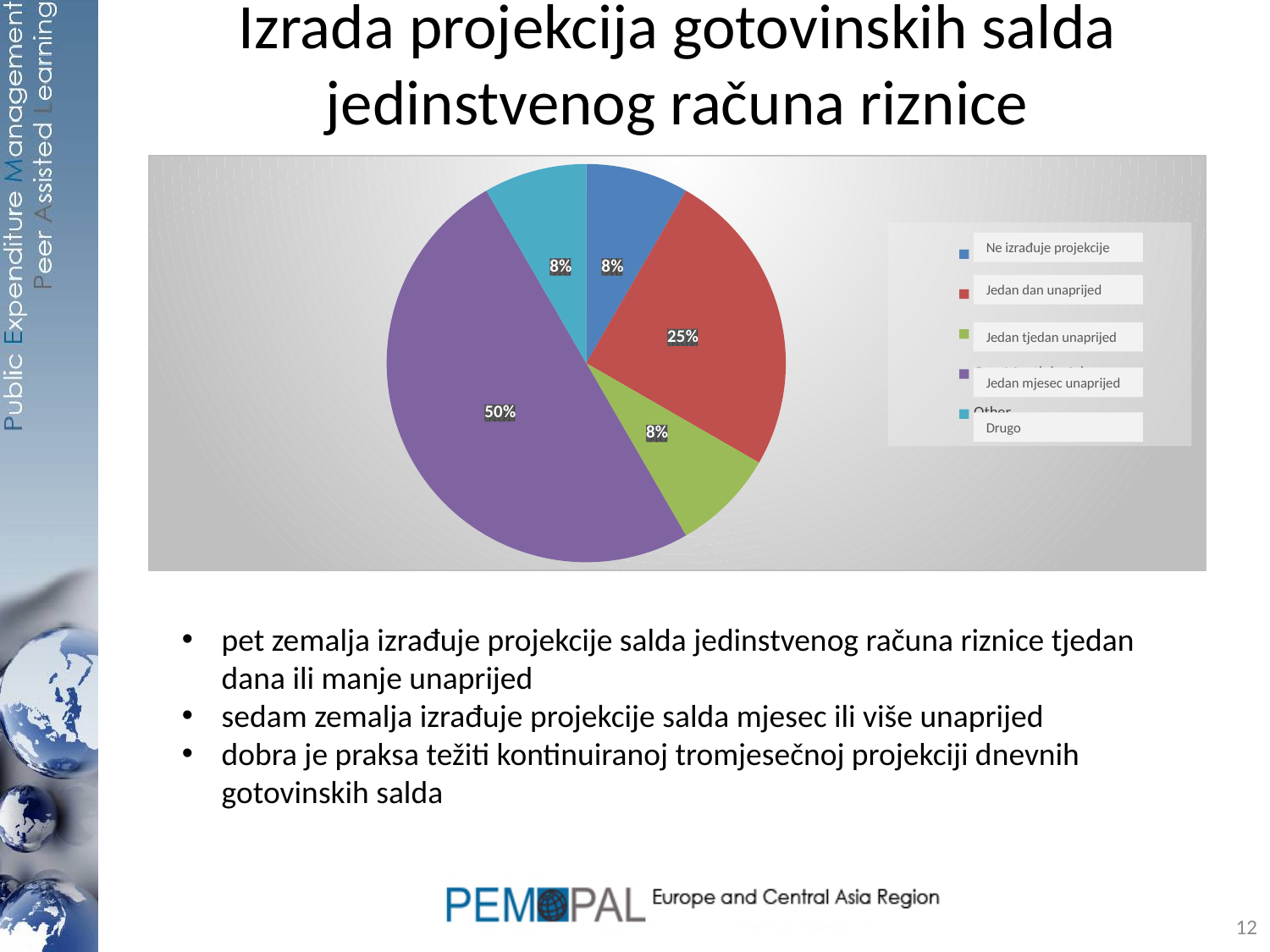
What kind of chart is shown on the slide? pie chart How many slices does the pie chart have? 5 What share of the pie does "Jedan tjedan unaprijed" represent? 8% What share of the pie does "Drugo" represent? 8% What colour is the slice for "Jedan mjesec unaprijed"? purple What share of the pie does "Ne izrađuje projekcije" represent? 8% How many entries does the legend list? 5 Which category has the largest slice of the pie? Jedan mjesec unaprijed What is the difference in percentage points between the "Jedan mjesec unaprijed" slice and the "Jedan dan unaprijed" slice? 25 Which is larger, the "Jedan dan unaprijed" slice or the "Drugo" slice? Jedan dan unaprijed